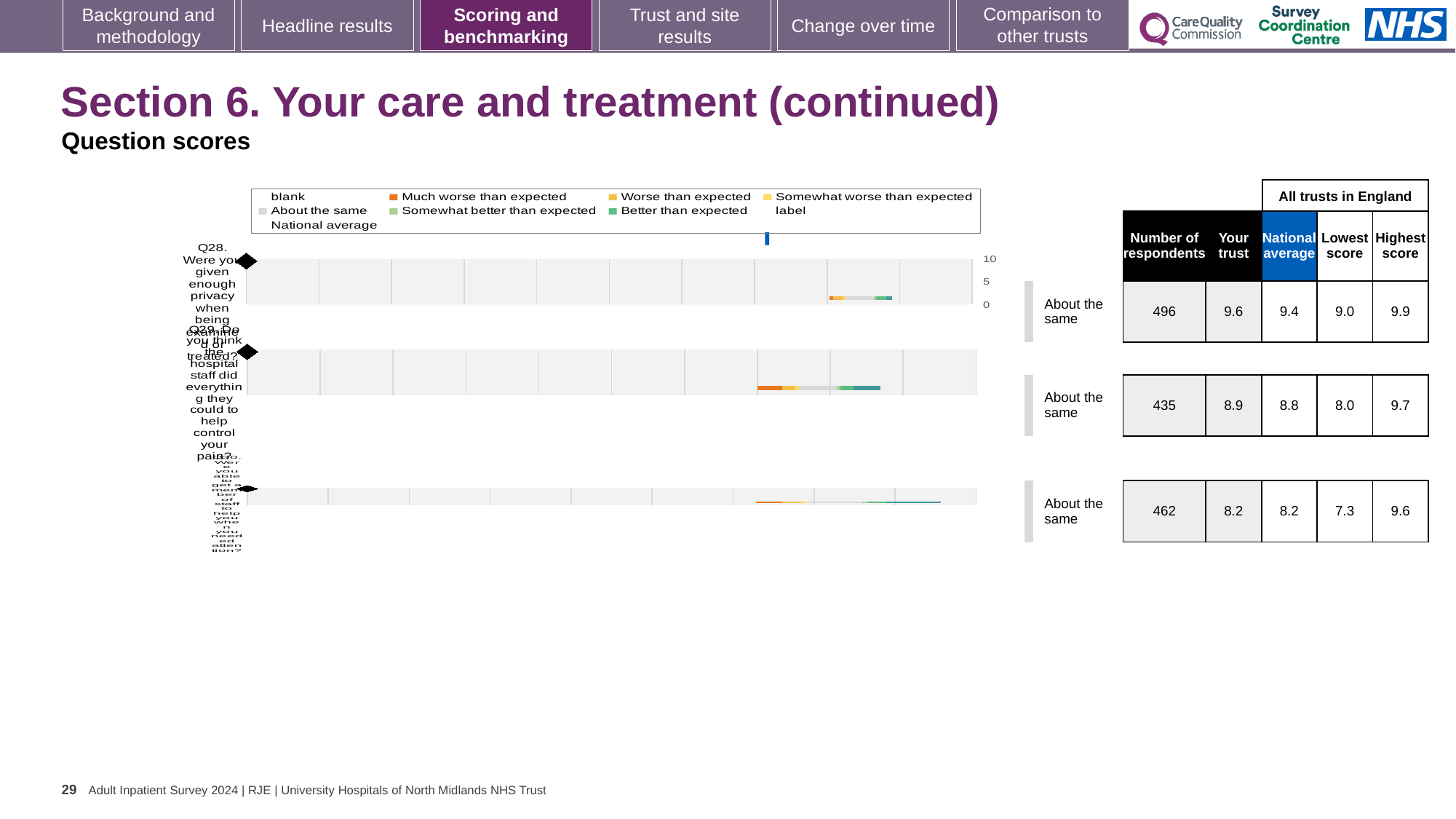
Which question on the slide has the highest 'Your trust' score? Q28 What is the national average score for Q29 (Do you think the hospital staff did everything they could to help control your pain?)? 8.8 For Q30, what is the difference between the highest score and the lowest score among all trusts in England? 2.3 How many questions are charted on the slide? 3 For Q28, how much higher is the 'Your trust' score than the national average? 0.2 What is the highest score among all trusts in England for Q28? 9.9 For Q29, which is larger: the 'Your trust' score or the national average? Your trust Which question on the slide has the lowest 'Your trust' score? Q30 What is the lowest score among all trusts in England for Q30, the third question on the slide? 7.3 What is the 'Your trust' score for Q28 (Were you given enough privacy when being examined or treated?)? 9.6 How many respondents answered Q30, the third question on the slide? 462 What benchmark category is shown for Q29? About the same